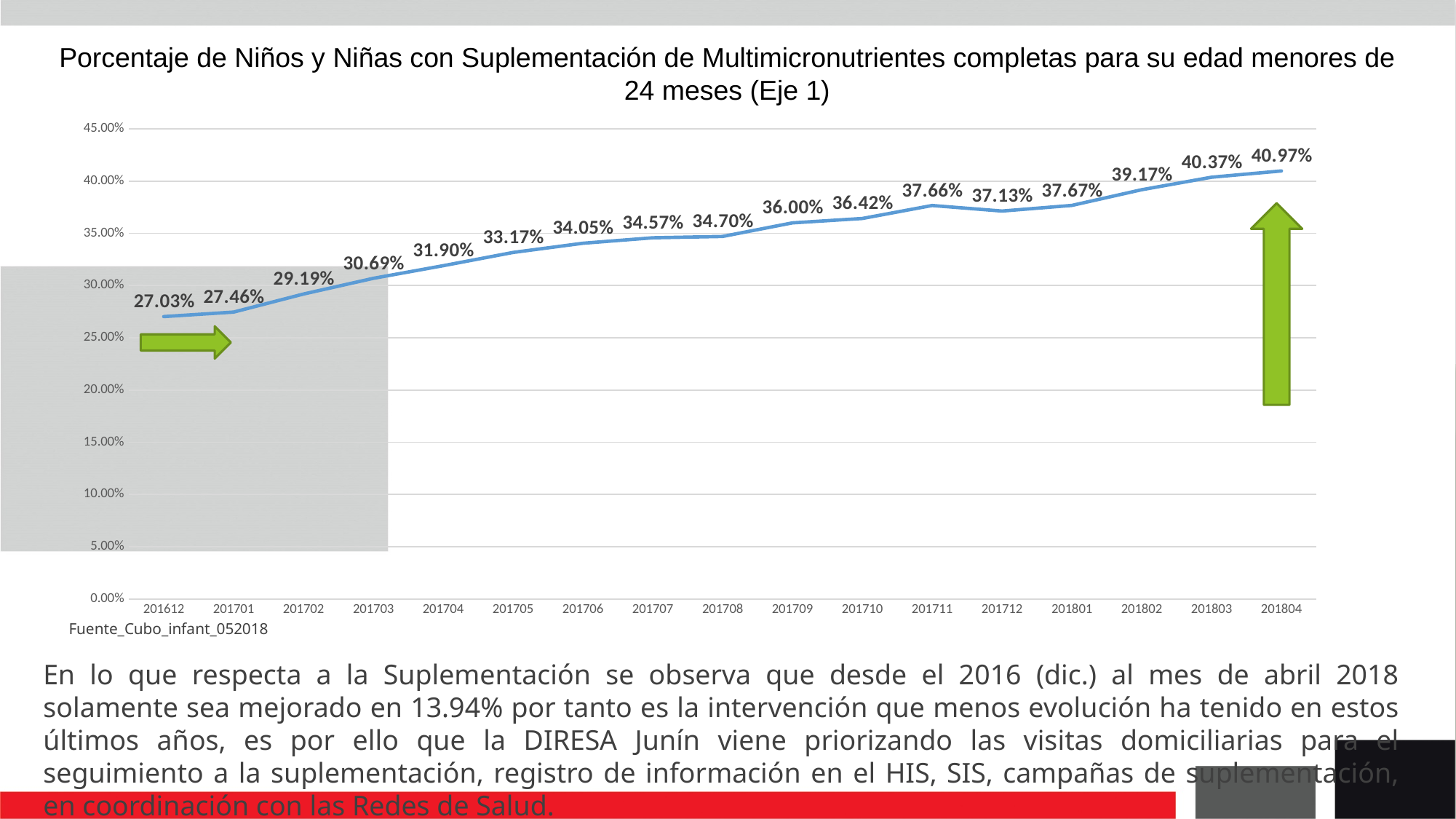
What is the difference between the values for 201804 and 201612? 13.94% What is the value for 201612? 27.03% Do the values generally rise or fall from 201612 to 201804? rise Which period has the lowest value? 201612 What is the difference between the values for 201712 and 201711? 0.53% What type of chart is shown on the slide? line chart Which period has the highest value? 201804 What source is cited below the chart? Fuente_Cubo_infant_052018 What is the value for 201804? 40.97% Which is larger, the value for 201711 or the value for 201712? 201711 What is the value for 201711? 37.66% How many data points are plotted on the chart? 17